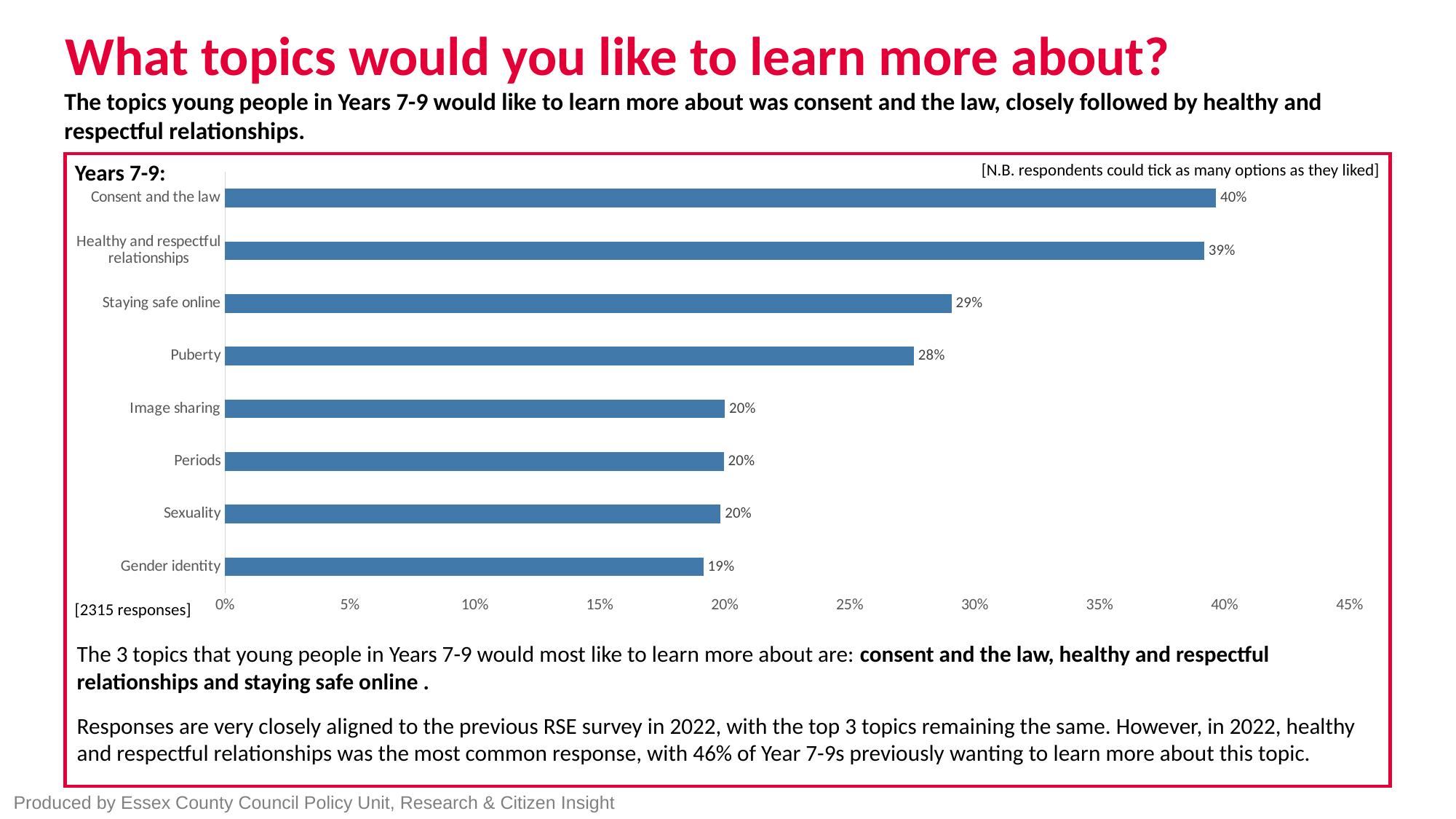
What percentage is shown for Puberty? 28% What kind of chart is shown on the slide? Bar chart How many responses does the chart note it is based on? 2315 What is the difference in percentage points between Consent and the law and Staying safe online? 11 Which topic has the lowest percentage in the chart? Gender identity What is the value for Gender identity? 19% Which has a higher value, Healthy and respectful relationships or Puberty? Healthy and respectful relationships What is the value shown for Staying safe online? 29% What percentage of Years 7-9 respondents would like to learn more about consent and the law? 40% Which topic has the highest percentage in the chart? Consent and the law Is the value for Image sharing greater or less than 25%? less How many topics are shown in the chart? 8